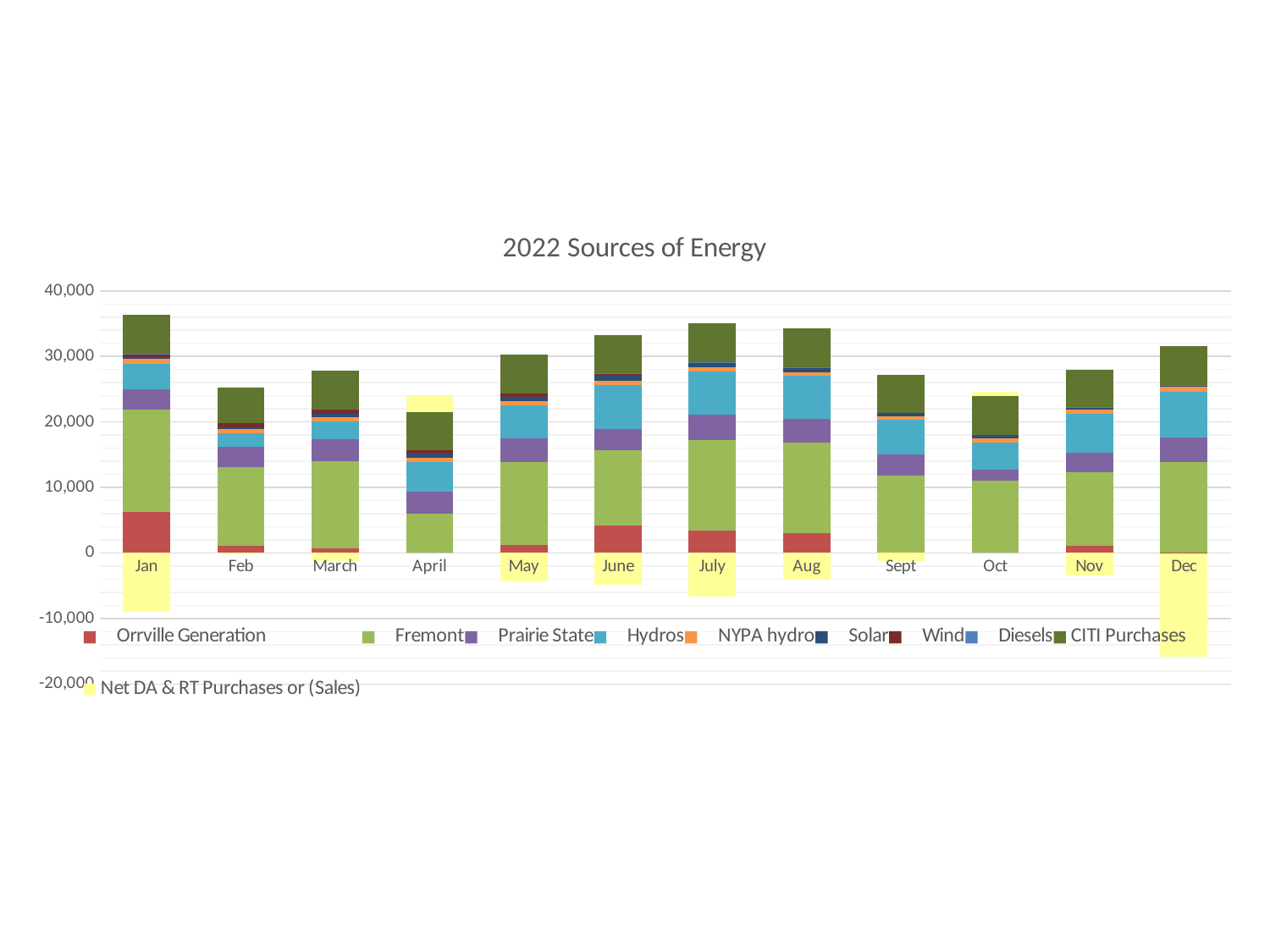
Is the Net DA & RT Purchases or (Sales) value for Dec greater or less than -10,000? less Which month has the largest negative Net DA & RT Purchases or (Sales) bar? Dec Is the total of the positive stacked bar for Jan greater or less than 30,000? greater How many months (categories) are shown on the x axis? 12 Which series is shown in yellow? Net DA & RT Purchases or (Sales) How many series does the legend list? 10 Which month has the lowest total positive stacked bar? April Is the Orrville Generation value for Jan greater or less than 10,000? less What is the title of the chart? 2022 Sources of Energy What kind of chart is shown on the slide? Stacked bar chart Which month has the larger total positive stacked bar, Jan or Feb? Jan